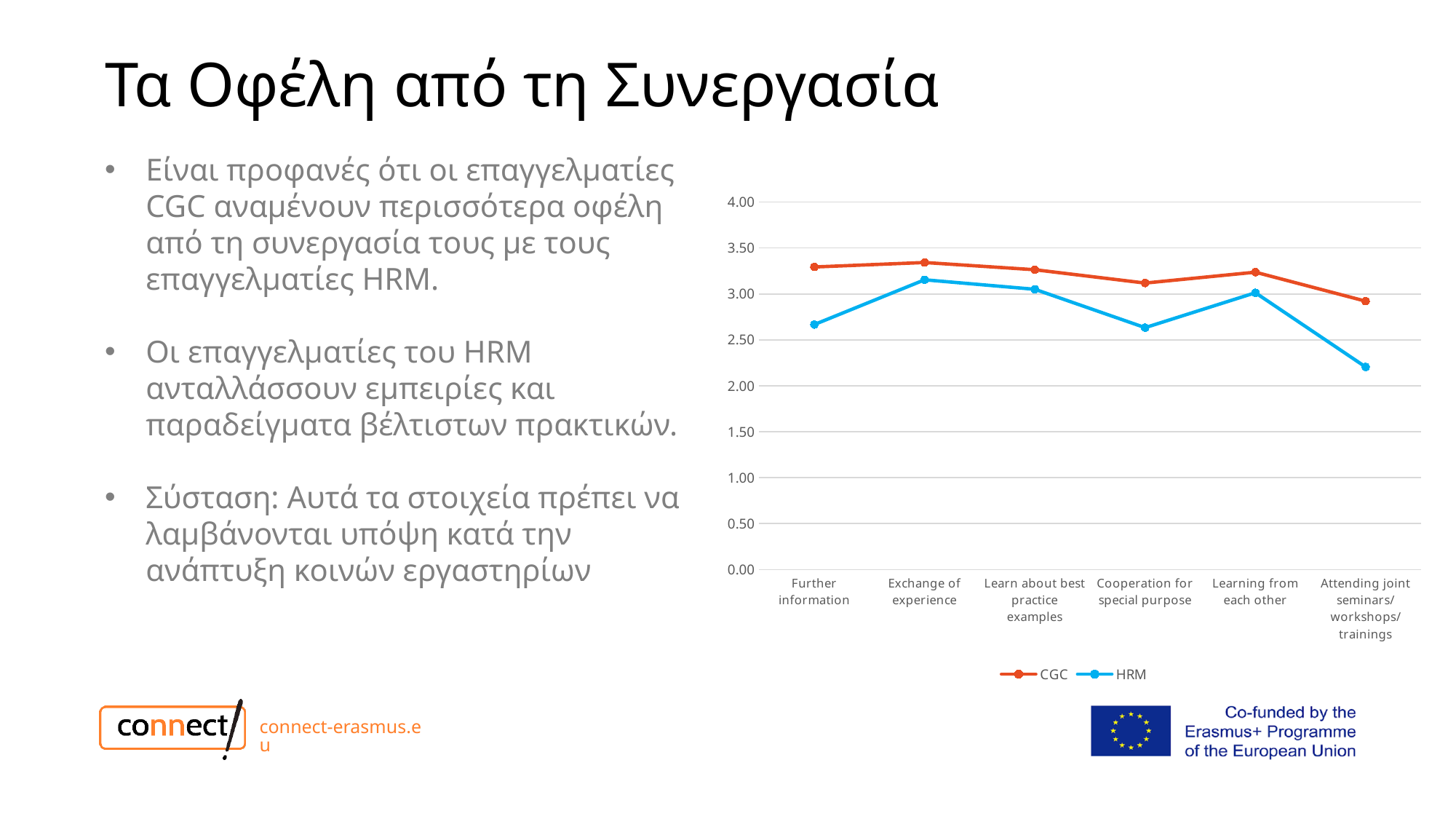
How many series does the legend list? 2 Which category has the highest value for the HRM series? Exchange of experience Is the HRM value for Attending joint seminars/workshops/trainings greater or less than 2.50? less Does the HRM line rise or fall from Learning from each other to Attending joint seminars/workshops/trainings? Fall Is the CGC value for Further information greater or less than 3.00? greater Which category has the lowest value for the HRM series? Attending joint seminars/workshops/trainings Which category has the lowest value for the CGC series? Attending joint seminars/workshops/trainings Which series is drawn in blue? HRM Which series has the larger value for Further information, CGC or HRM? CGC How many categories are shown on the x axis? 6 Is the HRM value for Further information greater or less than 3.00? less What kind of chart is shown on the slide? Line chart